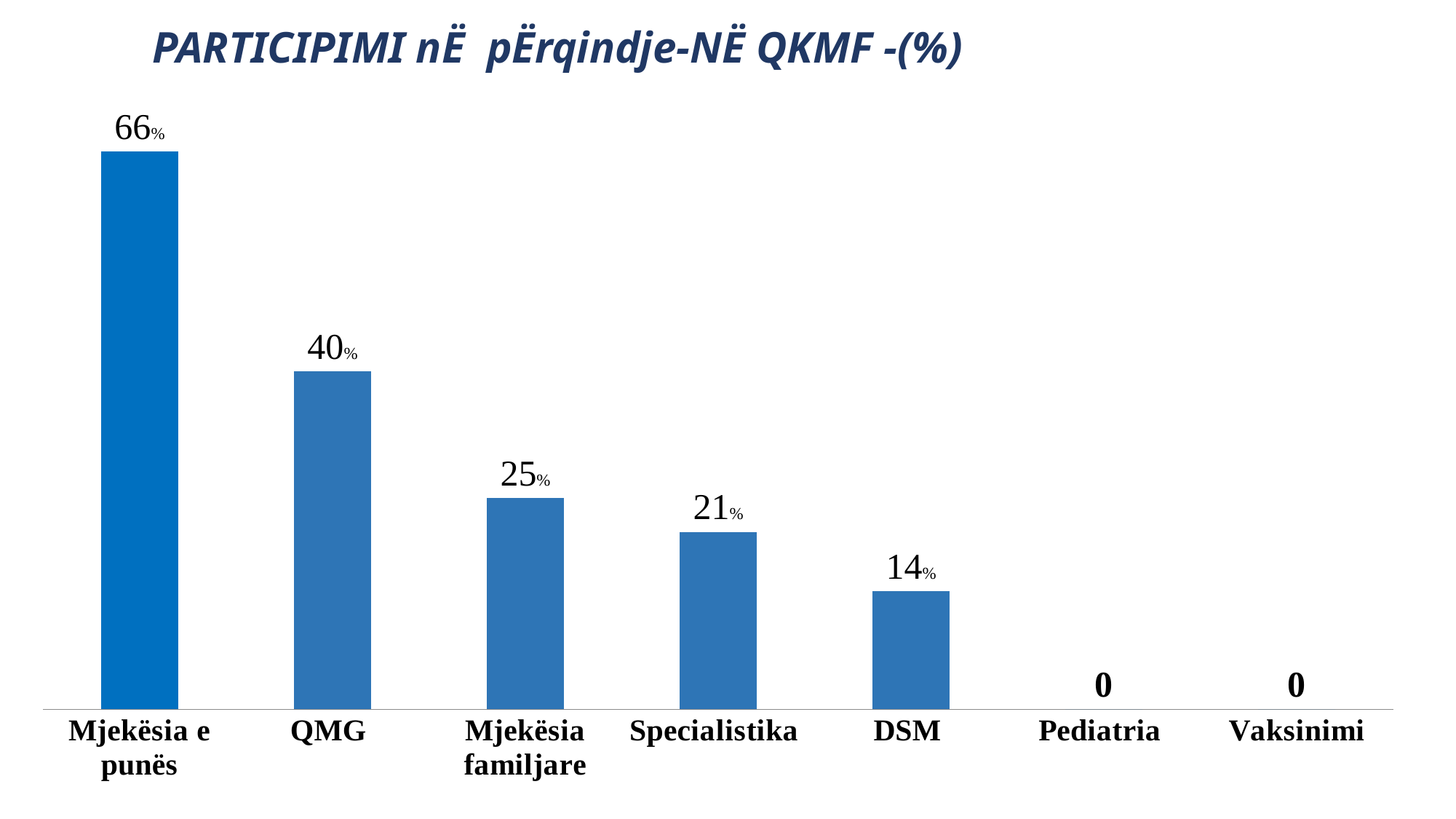
Which category has the highest value? Mjekësia e punës What is the value for QMG? 40% How many categories are shown on the x axis? 7 What is the difference between the values for Mjekësia e punës and QMG? 26% What kind of chart is this? Bar chart What is the value for DSM? 14% What is the difference between the values for Mjekësia familjare and DSM? 11% What is the value shown for Pediatria? 0 What is the value for Mjekësia e punës? 66% Which is larger, the value for Mjekësia familjare or the value for Specialistika? Mjekësia familjare What is the title of the chart? PARTICIPIMI nË pËrqindje-NË QKMF -(%) What is the value for Specialistika? 21%